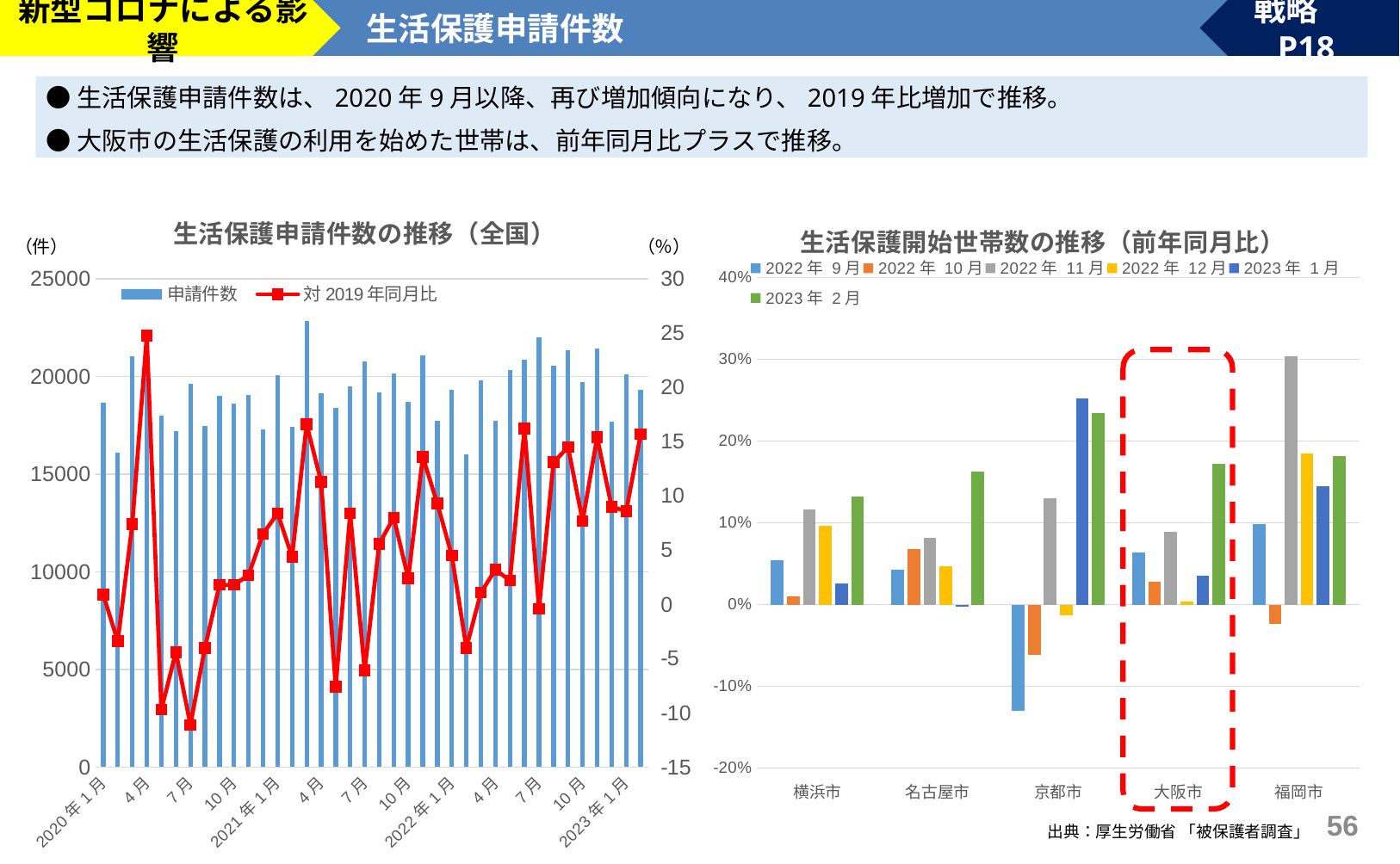
In the left chart, 生活保護申請件数の推移（全国）, is the 申請件数 bar for 2020年4月 greater or less than 20000? greater What kind of chart is the right chart, 生活保護開始世帯数の推移（前年同月比）? Bar chart In the right chart, 生活保護開始世帯数の推移（前年同月比）, how many series does the legend list? 6 What kind of chart is the left chart, 生活保護申請件数の推移（全国）? A bar chart combined with a line chart In the left chart, 生活保護申請件数の推移（全国）, how many series does the legend list? 2 In the right chart, 生活保護開始世帯数の推移（前年同月比）, is the value for 京都市 in 2022年9月 greater or less than -10%? less In the left chart, 生活保護申請件数の推移（全国）, is the 対2019年同月比 value for 2020年4月 greater or less than 20? greater In the left chart, 生活保護申請件数の推移（全国）, which series is drawn as the red line? 対2019年同月比 In the right chart, 生活保護開始世帯数の推移（前年同月比）, how many cities are shown on the x axis? 5 In the right chart, 生活保護開始世帯数の推移（前年同月比）, which month has the highest value for 福岡市? 2022年11月 In the right chart, 生活保護開始世帯数の推移（前年同月比）, which city is highlighted with a red dashed box? 大阪市